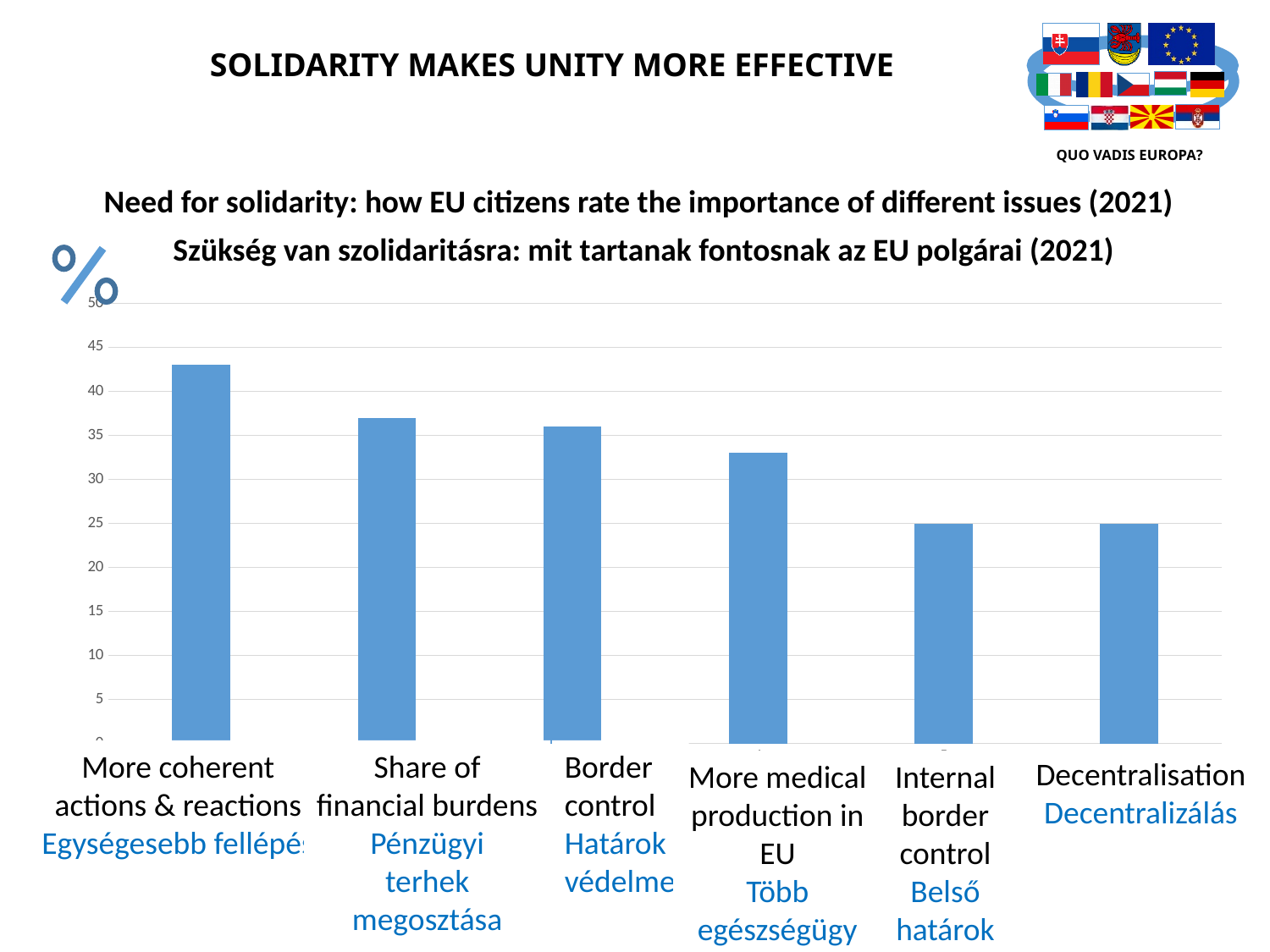
Is the value for More medical production in EU greater or less than 35? less Which is larger, the value for Share of financial burdens or the value for More medical production in EU? Share of financial burdens What type of chart is shown on the slide? bar chart What is the value for Decentralisation? 25 Do the values generally rise or fall from left to right across the categories? fall Is the value for Share of financial burdens greater or less than 35? greater Is the value for More coherent actions & reactions greater or less than 40? greater How many categories are shown in the chart? 6 What is the value for Internal border control? 25 Which category has the highest value in the chart? More coherent actions & reactions What is the English title of the chart? Need for solidarity: how EU citizens rate the importance of different issues (2021)